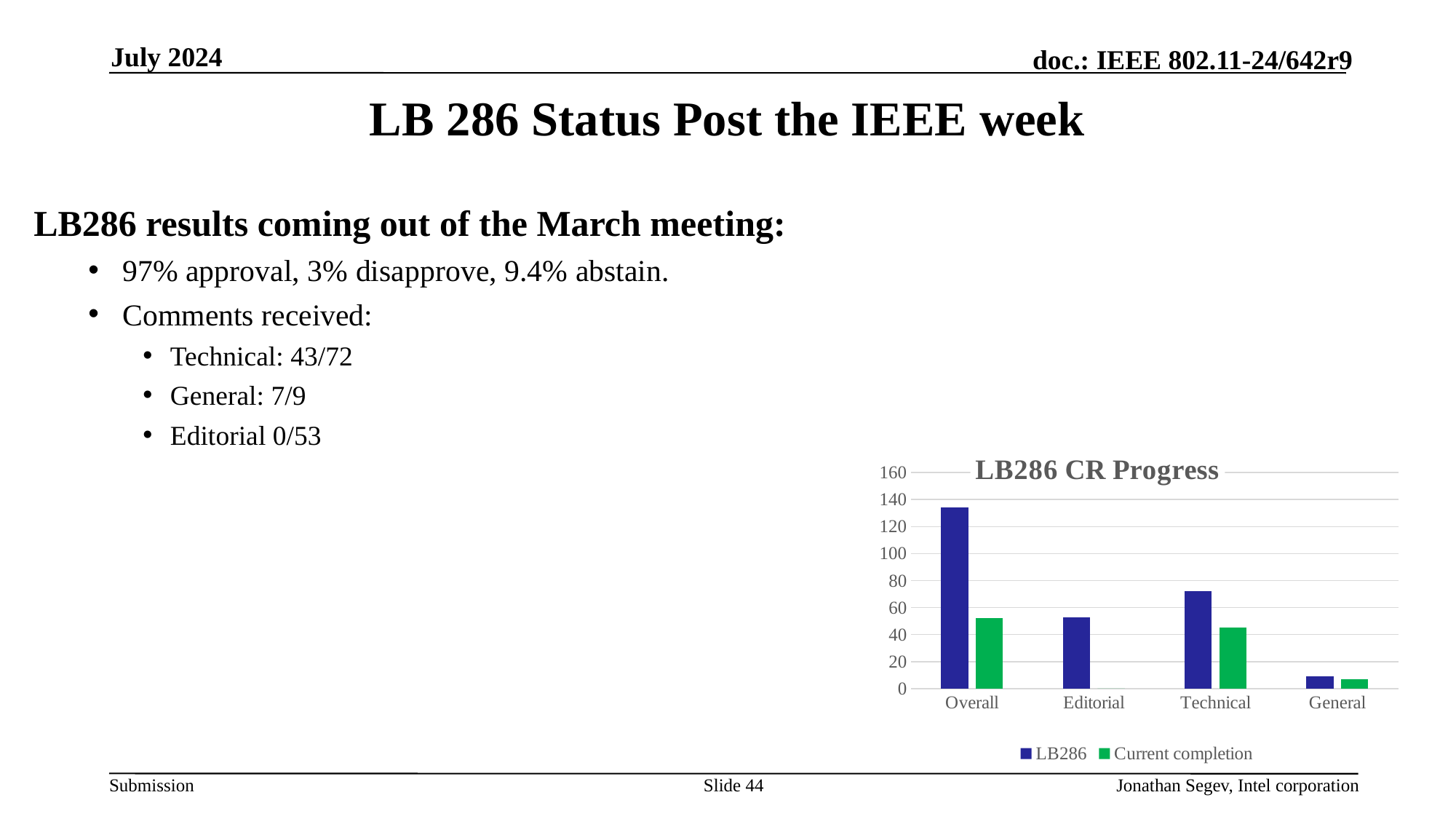
Which category has the highest Current completion value? Overall How many categories are shown on the x axis of the chart? 4 Is the LB286 value for Overall greater or less than 120? greater Which category has the highest LB286 value? Overall What kind of chart is shown on the slide? bar chart What is the title of the chart? LB286 CR Progress Is the Current completion value for Technical greater or less than 60? less Which category has the lowest LB286 value? General Which is larger, the LB286 value for Technical or the LB286 value for Editorial? Technical Is the LB286 value for Technical greater or less than 60? greater How many series does the chart legend list? 2